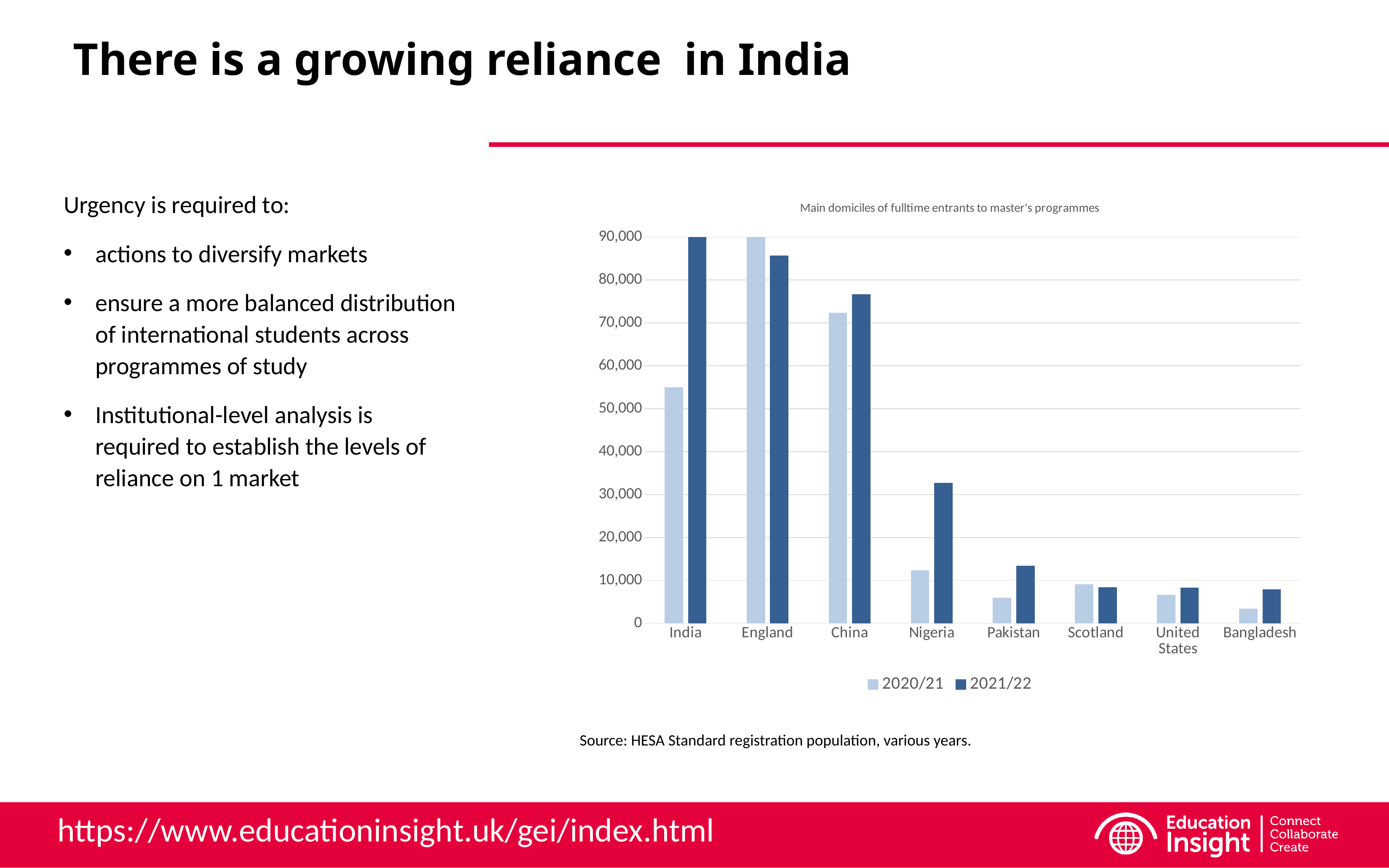
Which domicile has the highest value for the 2020/21 series? England Is the 2020/21 value for India greater or less than 60,000? less For England, which series has the larger value, 2020/21 or 2021/22? 2020/21 How many domiciles (categories) are shown on the x axis of the chart? 8 For India, which series has the larger value, 2020/21 or 2021/22? 2021/22 Which two series are listed in the chart legend? 2020/21 and 2021/22 Is the 2021/22 value for Nigeria greater or less than 30,000? greater Which domicile has the highest value for the 2021/22 series? India What kind of chart is shown on the slide? bar chart Which domicile has the lowest value for the 2020/21 series? Bangladesh What is the title of the chart? Main domiciles of fulltime entrants to master's programmes How many series does the chart legend list? 2